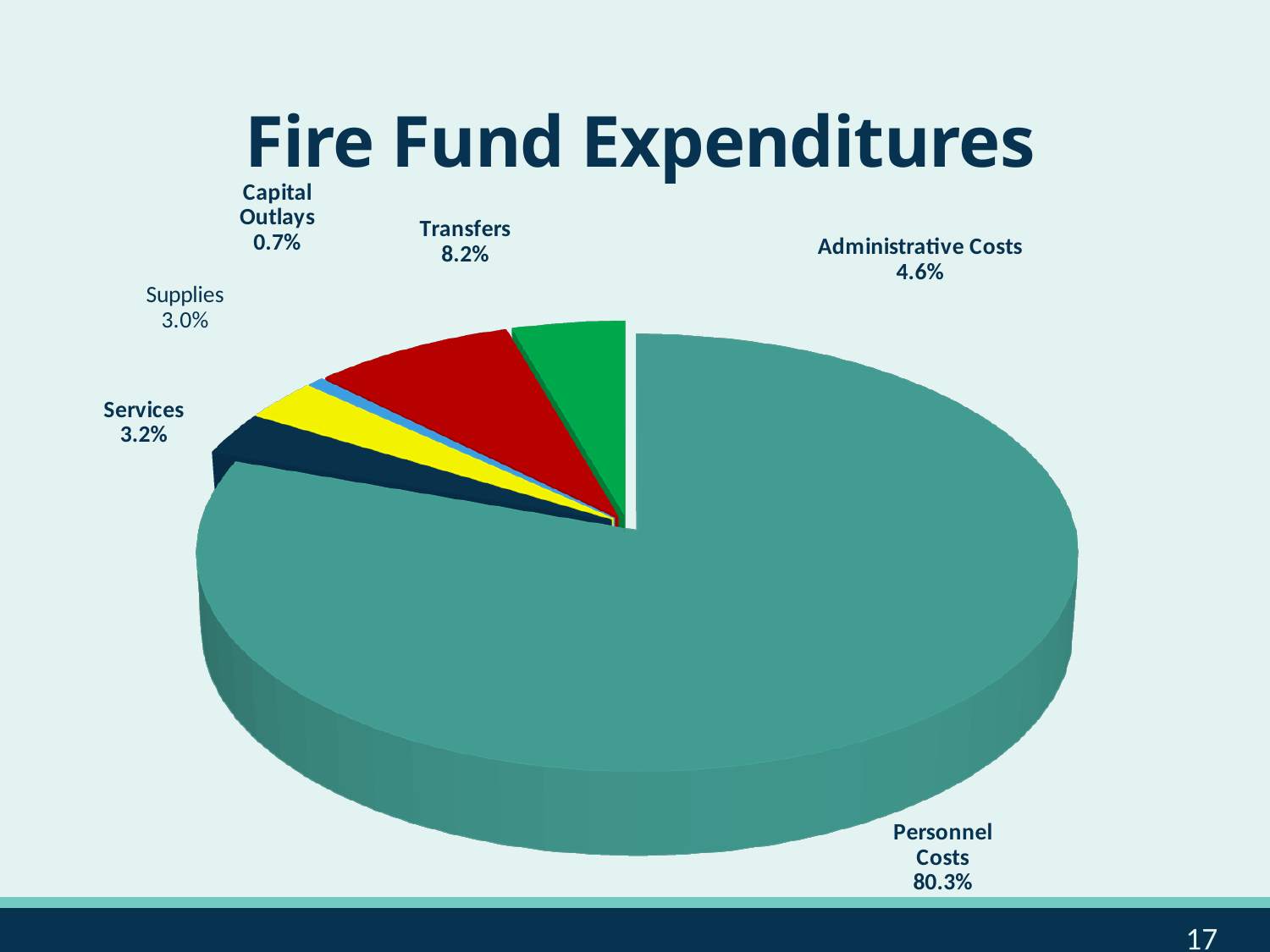
How many categories are shown in the pie chart? 6 What kind of chart is shown on the slide? Pie chart Which category has the largest share of Fire Fund Expenditures? Personnel Costs What is the difference between the share for Services and the share for Supplies? 0.2% What share of Fire Fund Expenditures is Supplies? 3.0% What is the title of the chart? Fire Fund Expenditures Which category has the smallest share of Fire Fund Expenditures? Capital Outlays Which is larger, the share for Transfers or the share for Administrative Costs? Transfers What share of Fire Fund Expenditures is Capital Outlays? 0.7% What share of Fire Fund Expenditures is Administrative Costs? 4.6%